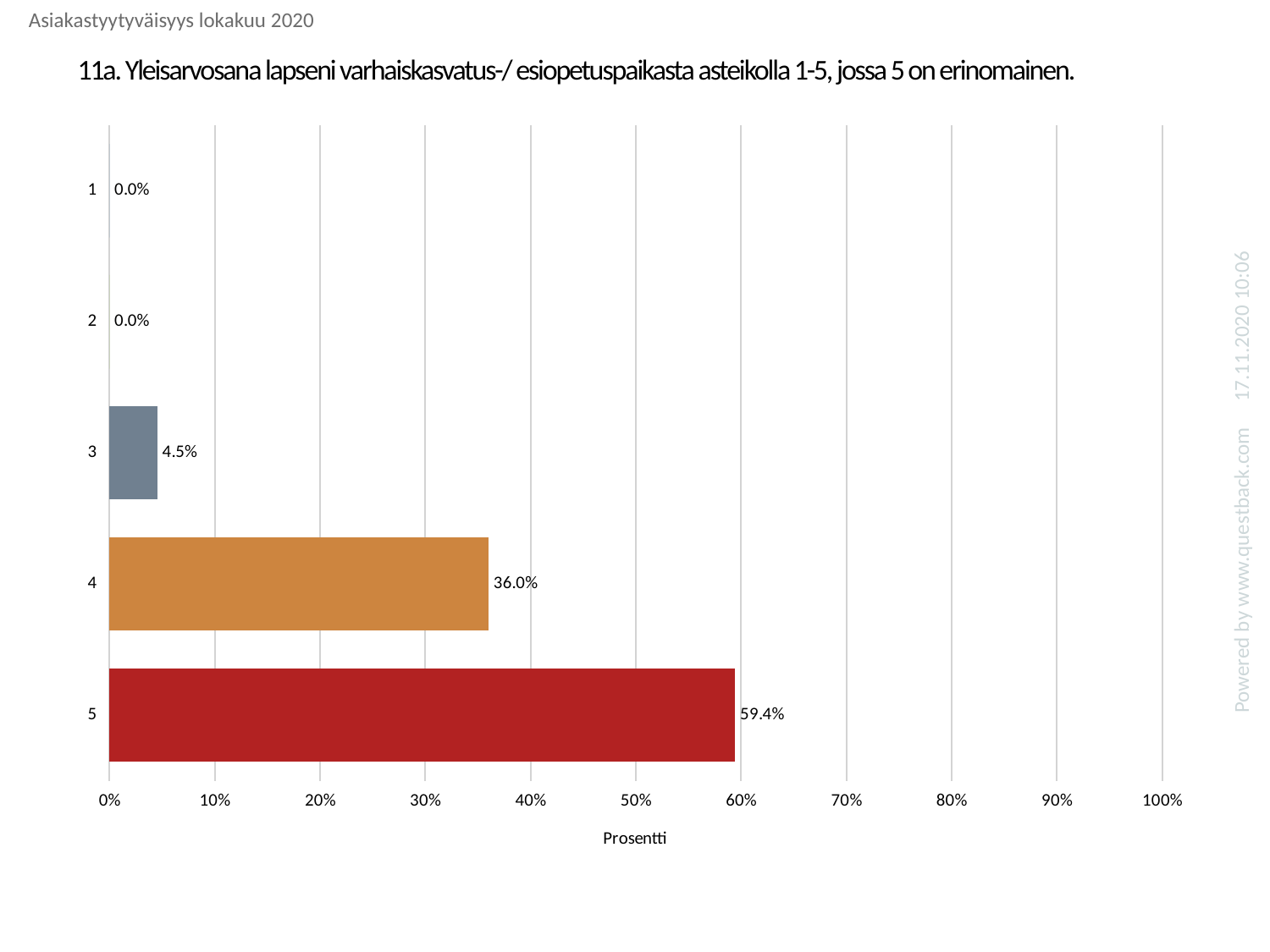
Which is larger, the value for category 3 or the value for category 4? 4 What is the difference between the values for category 5 and category 4? 23.4% What is the value for category 1? 0.0% Which category has the highest value? 5 Is the value for category 5 greater or less than 50%? greater What is the difference between the values for category 4 and category 3? 31.5% What is the value for category 5? 59.4% How many categories are shown on the chart? 5 What kind of chart is shown on the slide? bar chart What is the label of the horizontal axis? Prosentti What is the value for category 3? 4.5% What is the value for category 4? 36.0%